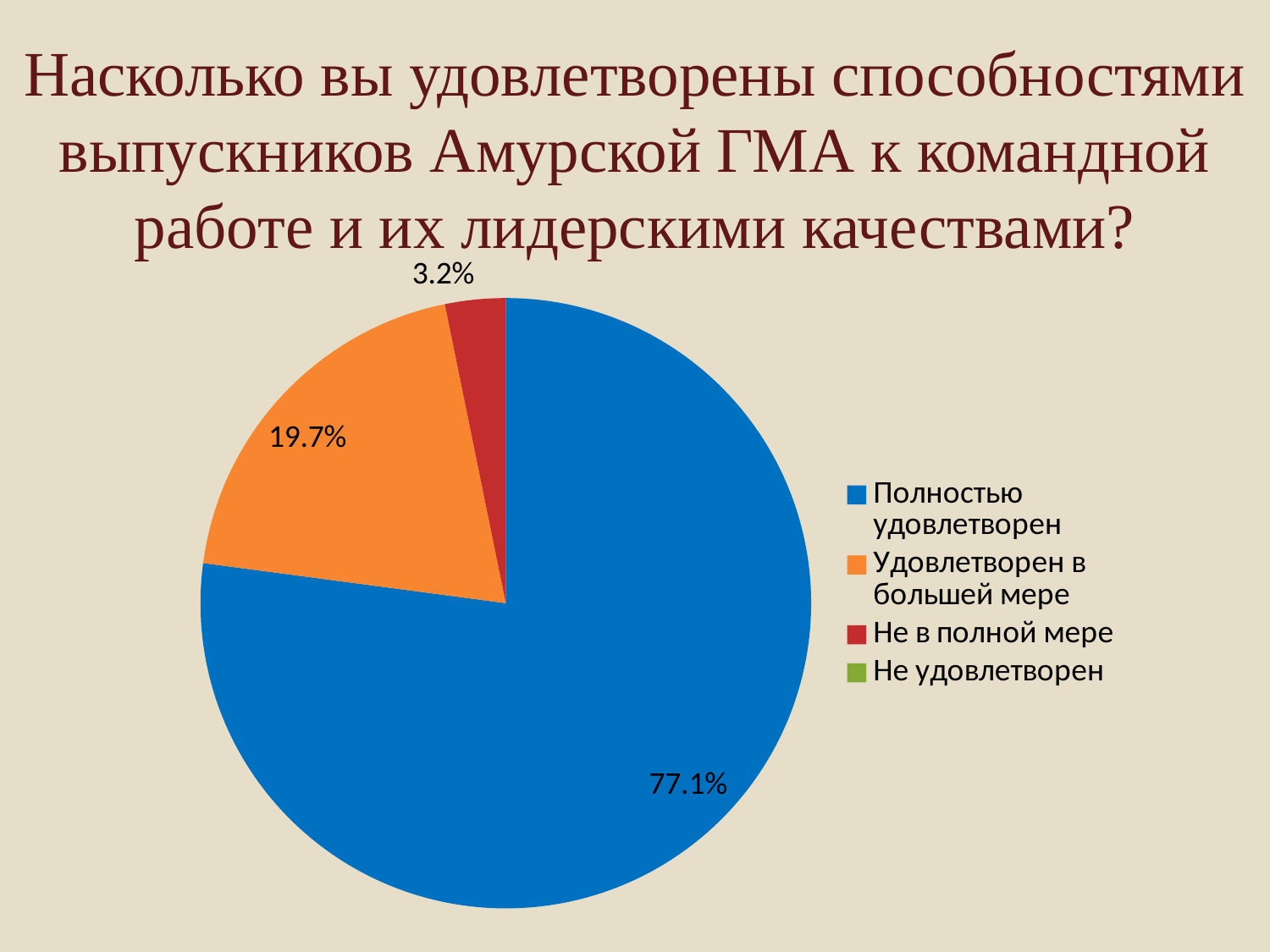
What share of respondents answered "Удовлетворен в большей мере"? 19.7% Which labelled slice of the pie is the smallest? Не в полной мере How many slices have a percentage label printed on the pie? 3 What share of respondents answered "Не в полной мере"? 3.2% What is the difference in percentage points between "Удовлетворен в большей мере" and "Не в полной мере"? 16.5 What is the difference in percentage points between "Полностью удовлетворен" and "Удовлетворен в большей мере"? 57.4 What kind of chart is shown on the slide? Pie chart Which response category has the largest share of the pie? Полностью удовлетворен Which is larger: the share for "Удовлетворен в большей мере" or the share for "Не в полной мере"? Удовлетворен в большей мере What share of respondents answered "Полностью удовлетворен"? 77.1% How many entries does the legend list? 4 What colour is the slice for "Полностью удовлетворен"? Blue